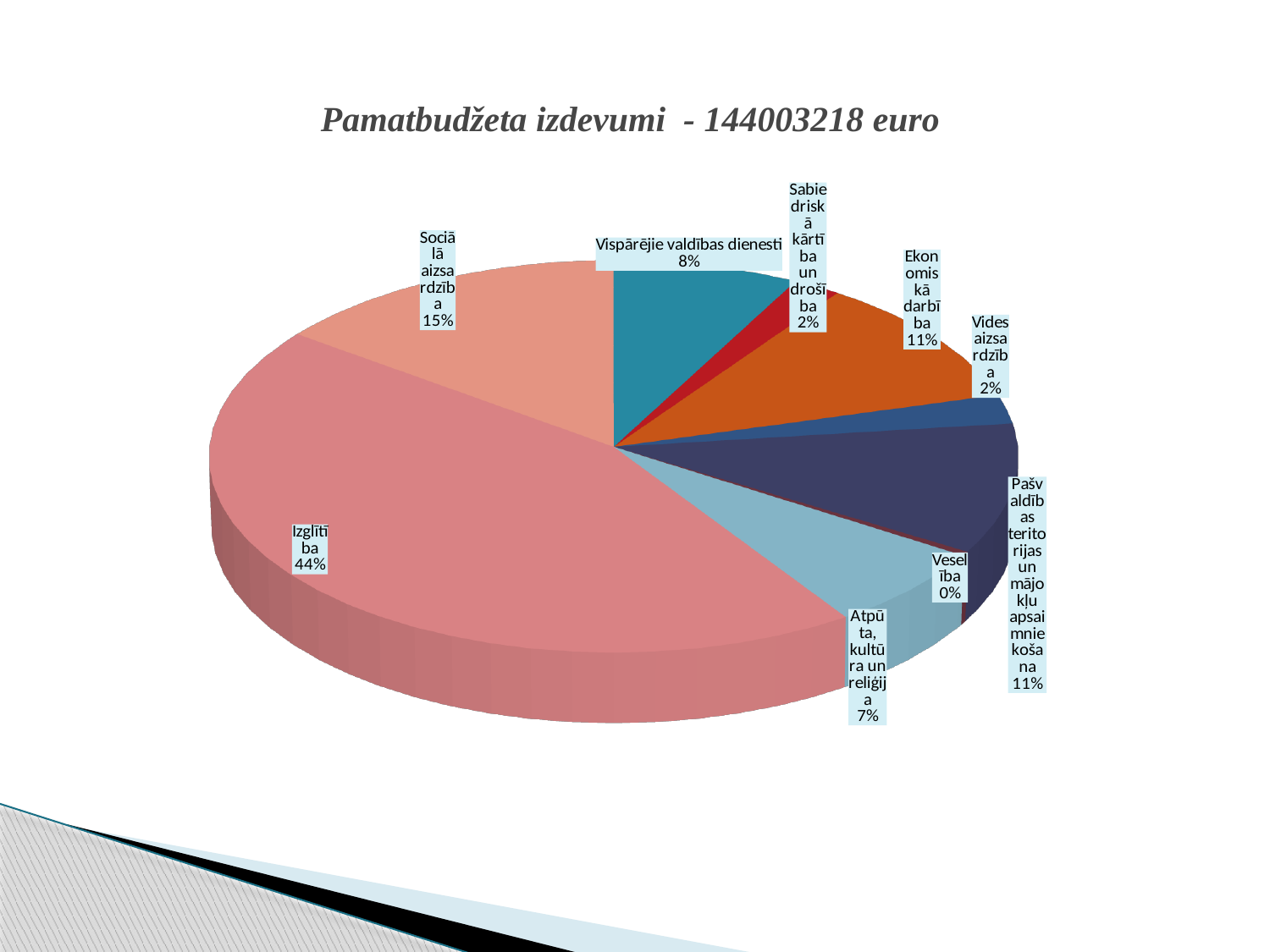
What is the value shown for Vispārējie valdības dienesti? 8% How many categories are shown in the pie chart? 9 Which is larger, the share for Ekonomiskā darbība or the share for Vispārējie valdības dienesti? Ekonomiskā darbība What share of the pie does Izglītība take? 44% Which category has the smallest slice of the pie? Veselība Which category has the largest slice of the pie? Izglītība What kind of chart is shown on the slide? pie chart What is the value shown for Veselība? 0% What is the difference between the shares of Izglītība and Sociālā aizsardzība? 29% What is the title of the chart? Pamatbudžeta izdevumi - 144003218 euro What is the value shown for Atpūta, kultūra un reliģija? 7% What share of the pie does Sociālā aizsardzība take? 15%